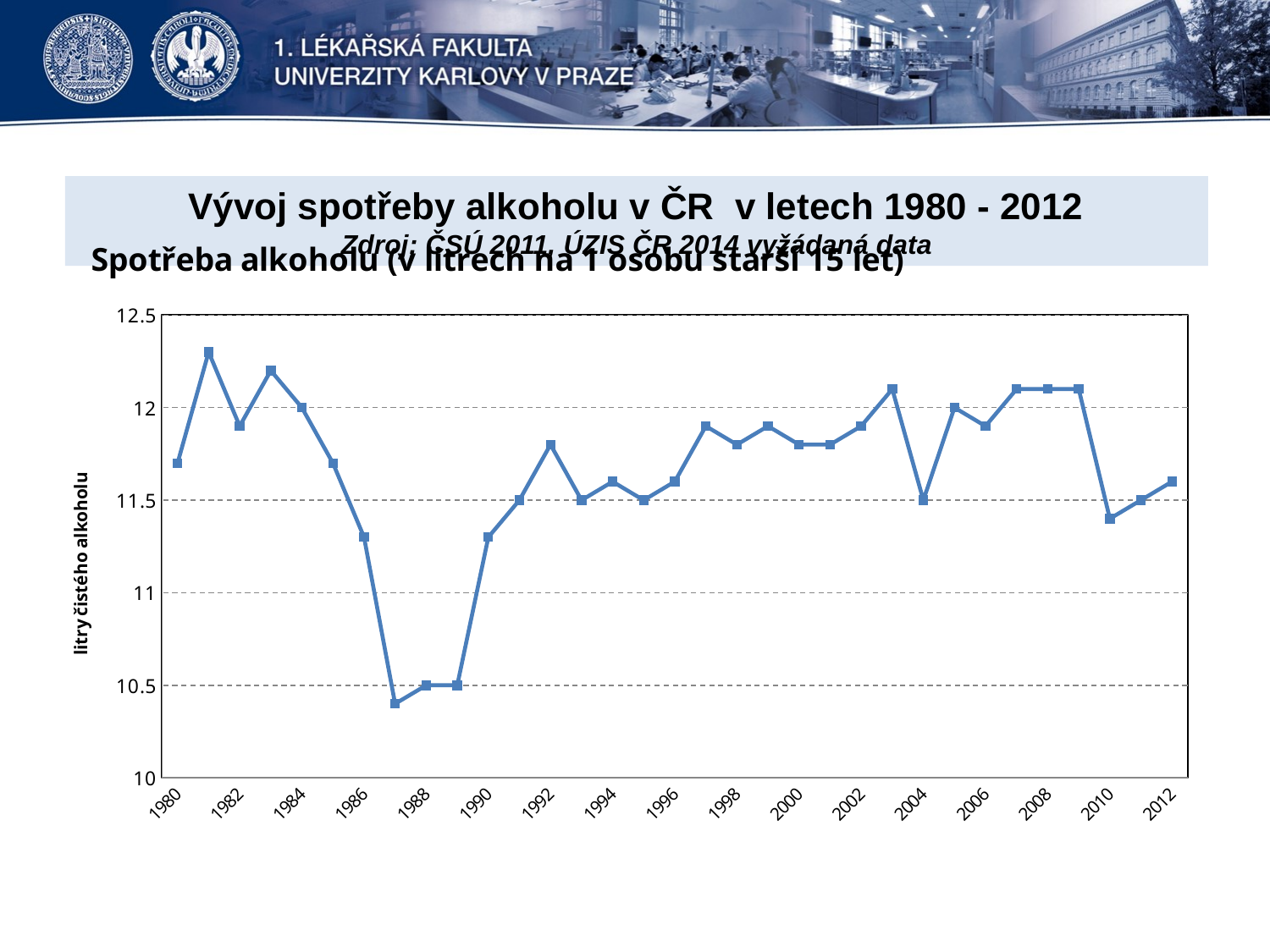
Do the values rise or fall between 1987 and 1992? rise What is the value for 1984? 12 Which year has the lowest alcohol consumption value in the chart? 1987 What is the value for 1988? 10.5 Is the value for 1990 greater or less than 11.5? less Is the value for 1986 greater or less than 11.5? less Is the value for 1981 greater or less than 12? greater Which year has the larger value, 1981 or 1987? 1981 What kind of chart is shown on the slide? line chart What is the label of the vertical axis? litry čistého alkoholu Do the values rise or fall between 1984 and 1987? fall